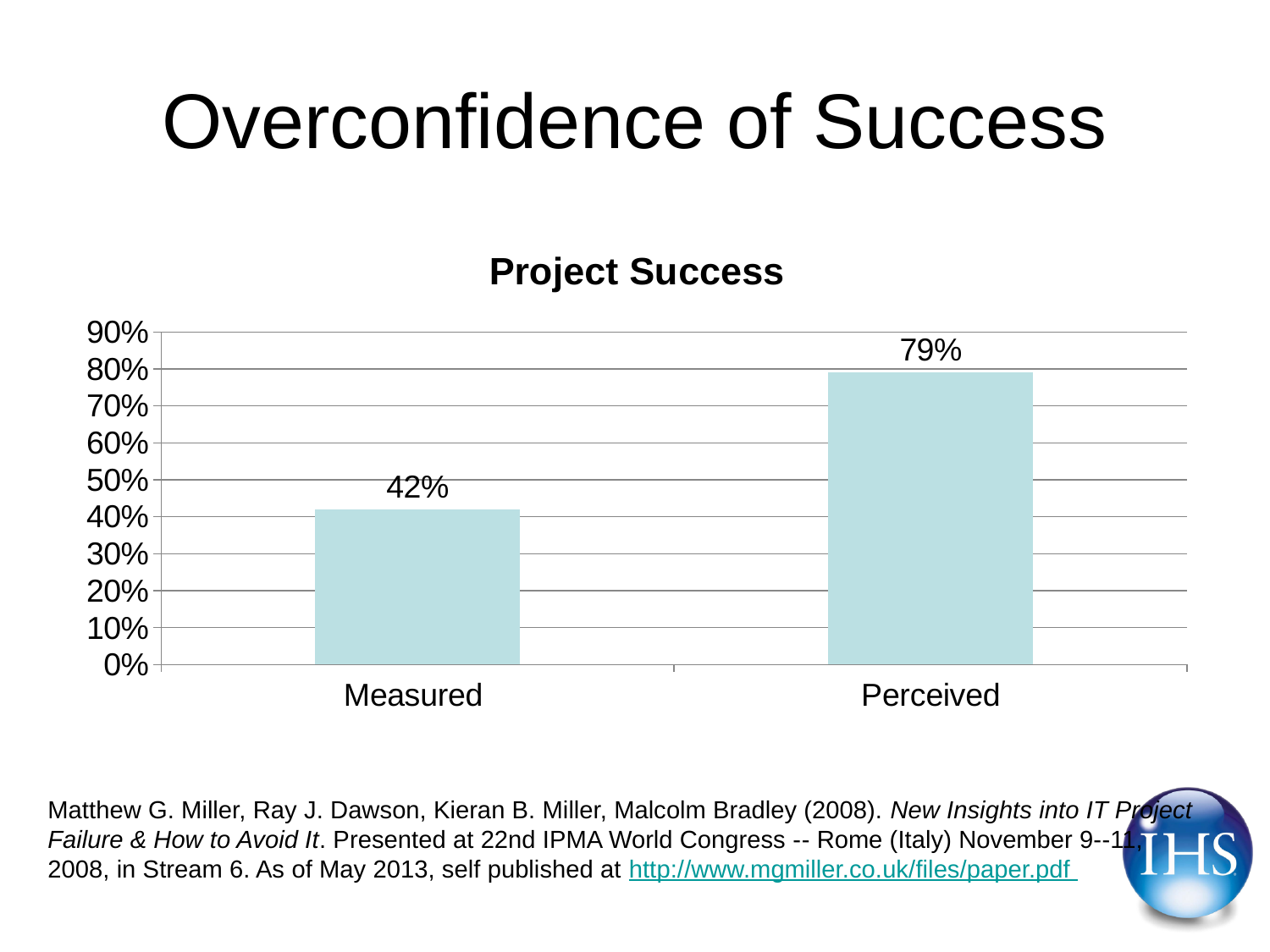
What kind of chart is shown on the slide? bar chart What is the difference between the Perceived and Measured values? 37% What is the title of the chart? Project Success Which category has the lowest value? Measured Is the value for Measured greater or less than 50%? less How many categories are shown in the chart? 2 Which category has the highest value? Perceived What is the value for Measured? 42% Which is larger, the value for Measured or the value for Perceived? Perceived What is the value for Perceived? 79% Is the value for Perceived greater or less than 70%? greater What is the highest value shown on the vertical axis? 90%